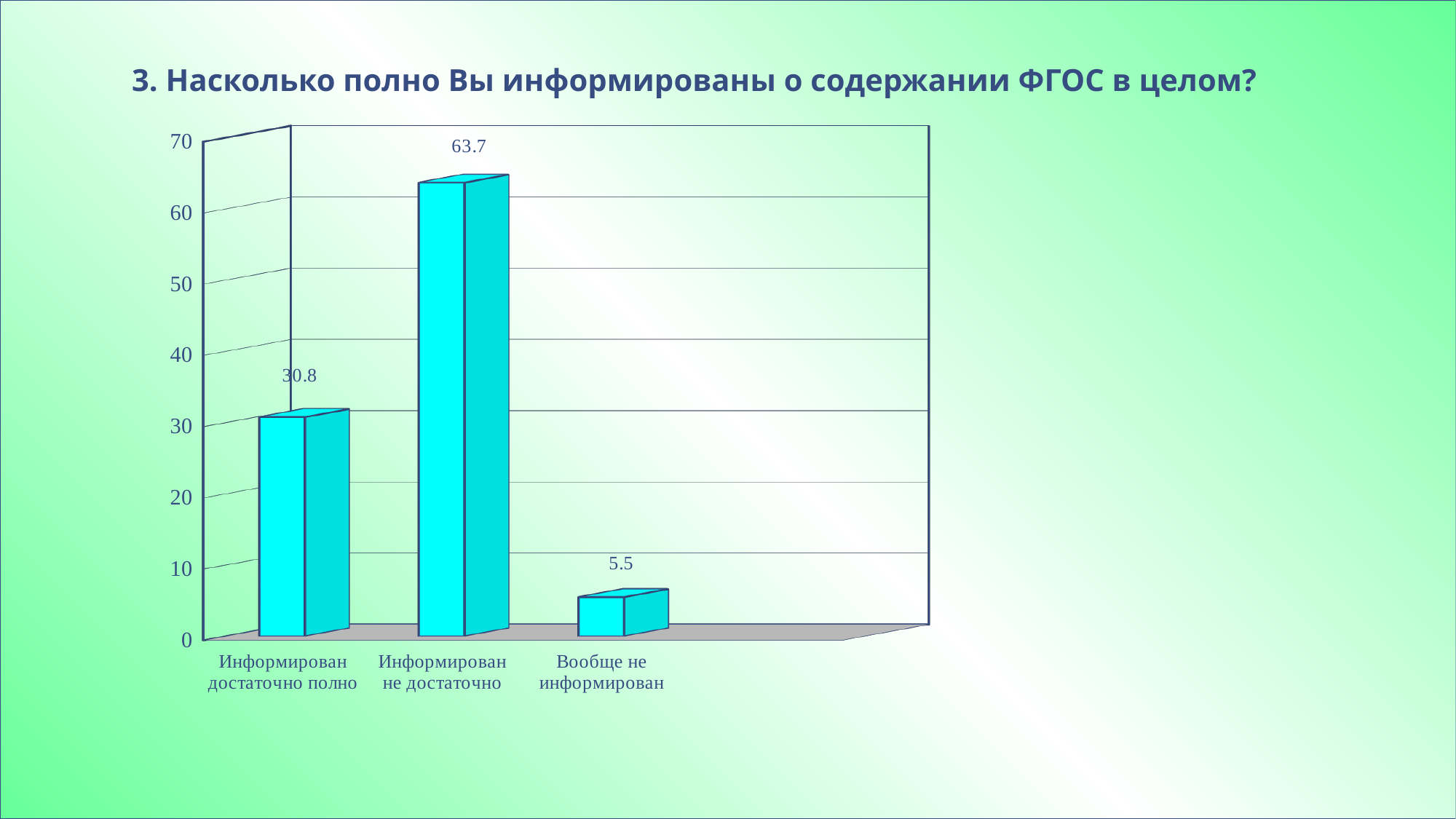
Which is larger: the value for "Информирован достаточно полно" or for "Вообще не информирован"? Информирован достаточно полно What kind of chart is shown on the slide? bar chart What is the difference between the values for "Информирован достаточно полно" and "Вообще не информирован"? 25.3 How many categories are shown in the chart? 3 What is the difference between the values for "Информирован не достаточно" and "Информирован достаточно полно"? 32.9 Which category has the highest value? Информирован не достаточно What is the title of the slide above the chart? 3. Насколько полно Вы информированы о содержании ФГОС в целом? Which category has the lowest value? Вообще не информирован What is the value for "Информирован достаточно полно"? 30.8 What is the value for "Вообще не информирован"? 5.5 Is the value for "Информирован не достаточно" greater or less than 60? greater What is the value for "Информирован не достаточно"? 63.7